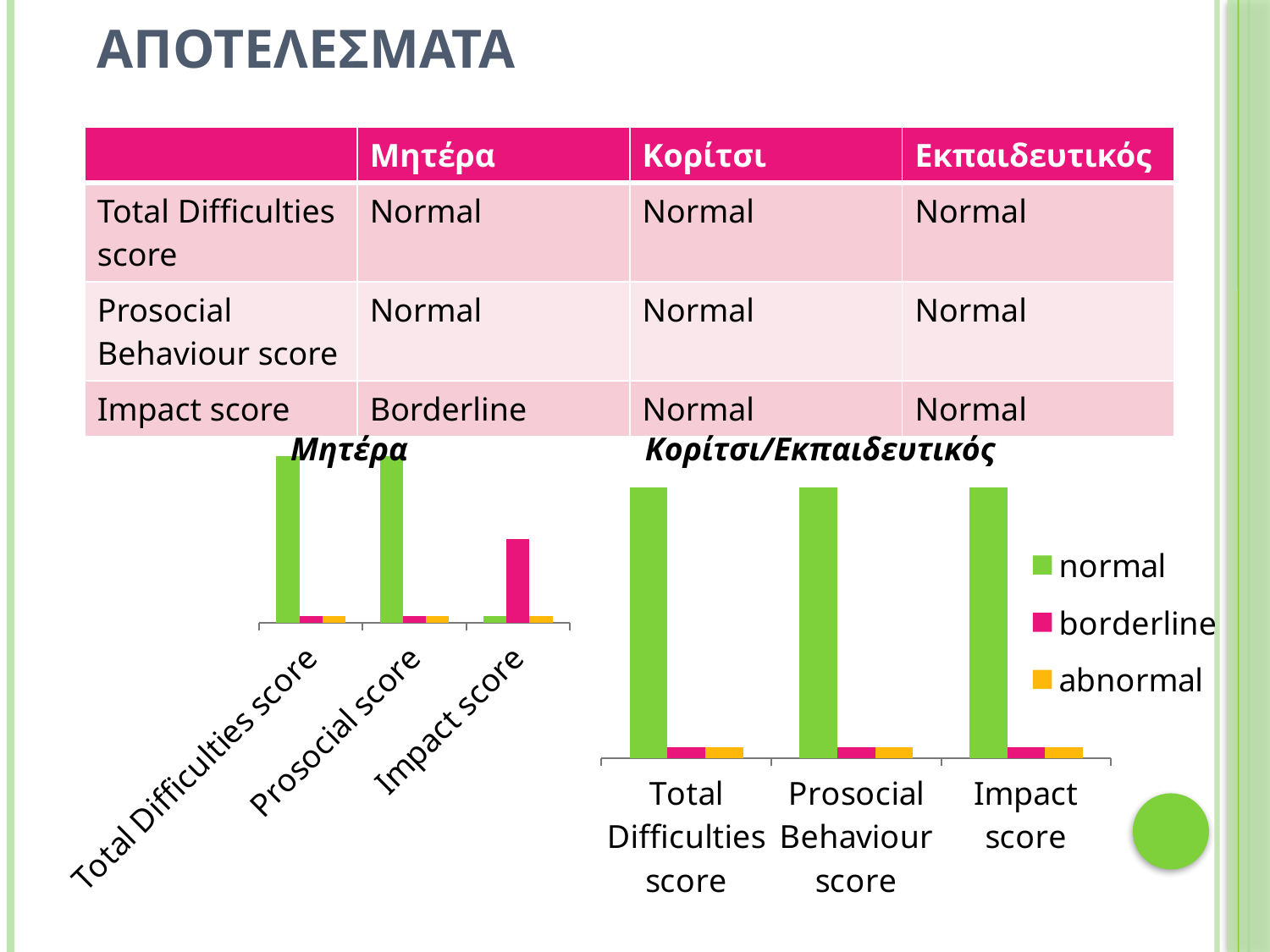
In the Μητέρα chart, which series has the tallest bar for Total Difficulties score? normal What kind of chart is the Μητέρα chart on the left? bar chart In the Μητέρα chart, which series has the tallest bar for Impact score? borderline What colour represents the borderline series in the legend? pink How many series does the legend of the Κορίτσι/Εκπαιδευτικός chart list? 3 In the Κορίτσι/Εκπαιδευτικός chart, is the normal bar or the abnormal bar taller for Prosocial Behaviour score? normal In the Μητέρα chart, which series has the tallest bar for Prosocial score? normal What kind of chart is the Κορίτσι/Εκπαιδευτικός chart on the right? bar chart How many categories are shown on the x axis of the Μητέρα chart? 3 How many categories are shown on the x axis of the Κορίτσι/Εκπαιδευτικός chart? 3 In the Μητέρα chart, is the normal bar or the borderline bar taller for Impact score? borderline